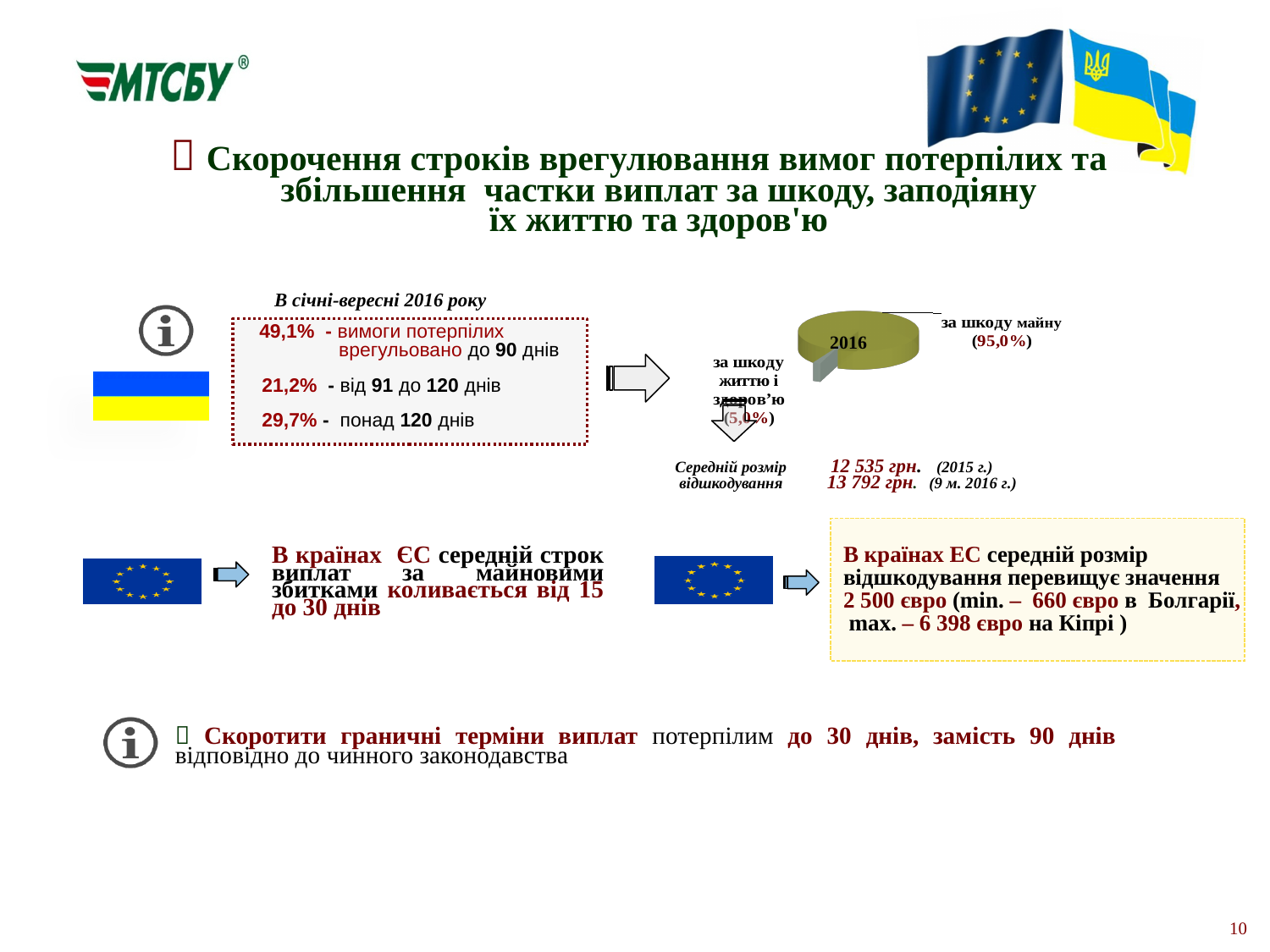
What kind of chart is shown on the slide? pie chart What year label is printed on the pie chart? 2016 Which is larger in the pie chart: the share for "за шкоду майну" or the share for "за шкоду життю і здоров'ю"? за шкоду майну What is the combined share of the two slices in the pie chart? 100,0% Which slice of the pie chart is the largest? за шкоду майну In the pie chart, what share is labelled "за шкоду майну"? 95,0% By how many percentage points does the "за шкоду майну" slice exceed the "за шкоду життю і здоров'ю" slice? 90,0 How many slices does the pie chart have? 2 Which slice of the pie chart is the smallest? за шкоду життю і здоров'ю In the pie chart, what share is labelled "за шкоду життю і здоров'ю"? 5,0%